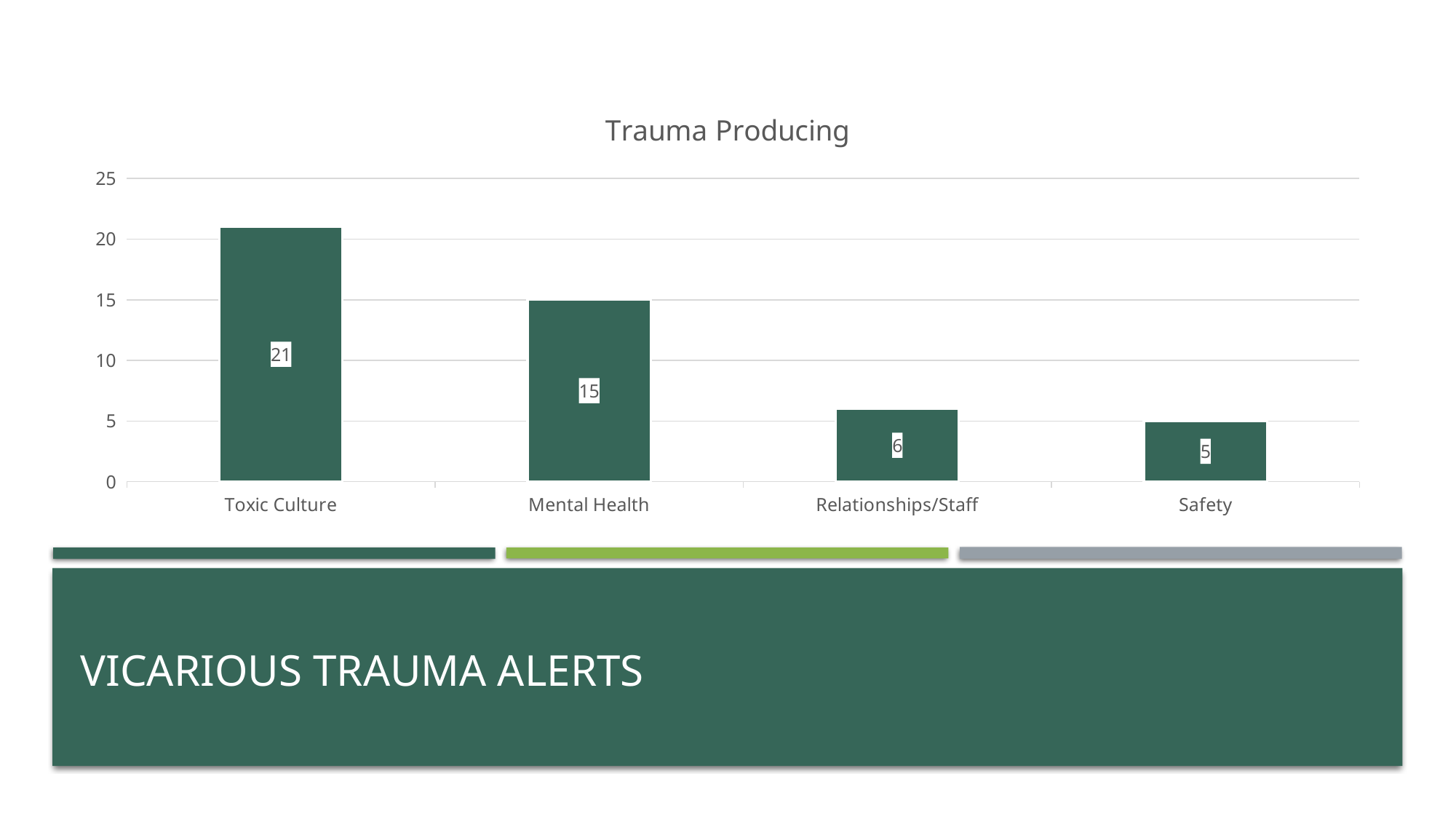
How many categories are shown on the x axis? 4 Which is larger, the value for Mental Health or the value for Relationships/Staff? Mental Health What kind of chart is shown on the slide? bar chart Is the value for Toxic Culture greater or less than 20? greater What is the value for Mental Health? 15 What is the title of the chart? Trauma Producing Which category has the highest value? Toxic Culture What is the value for Relationships/Staff? 6 What is the difference between the values for Toxic Culture and Mental Health? 6 What is the value for Safety? 5 Which category has the lowest value? Safety What is the value for Toxic Culture? 21